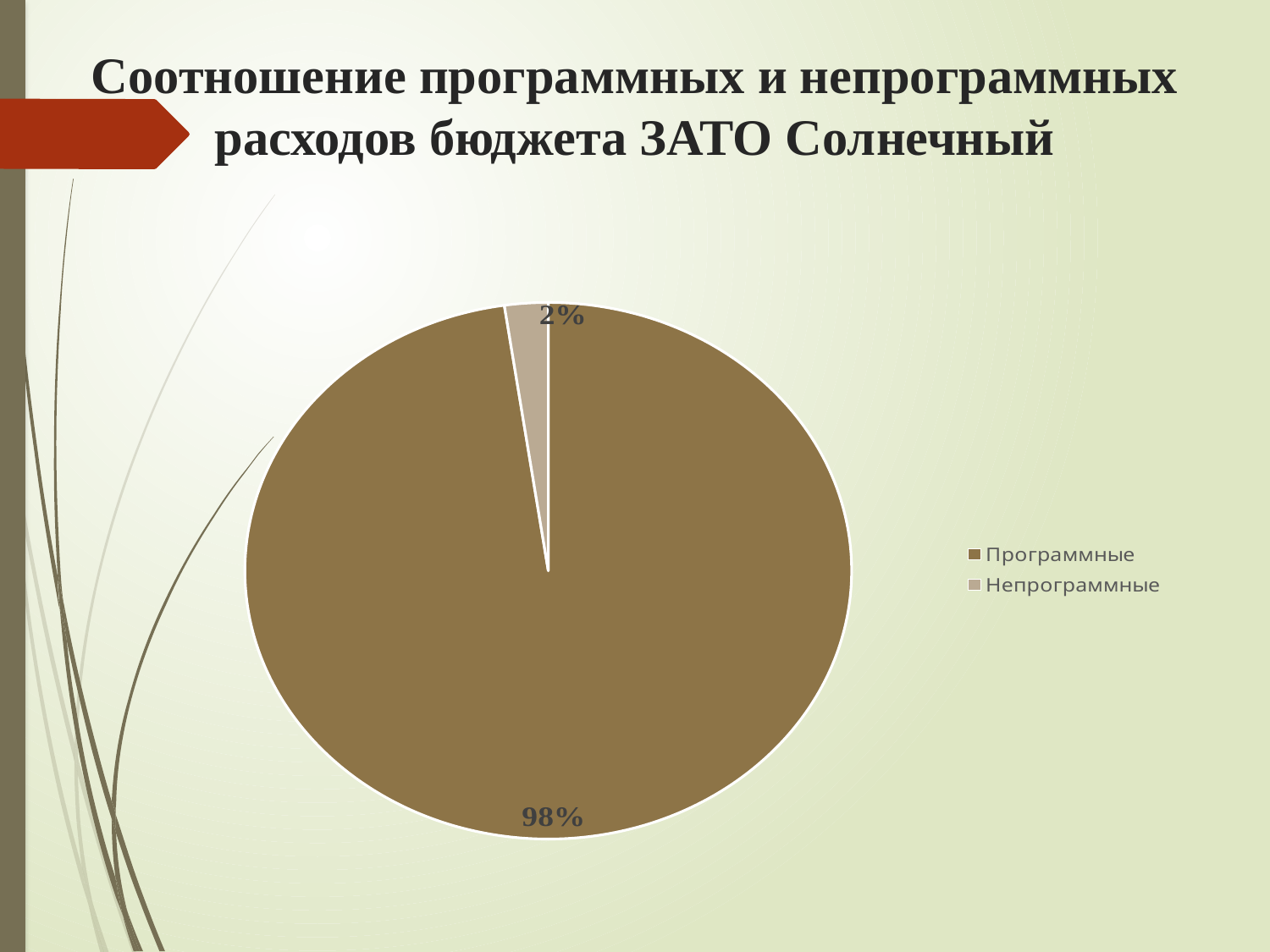
What share of the pie does Непрограммные take? 2% Which legend entry is listed first? Программные How many slices does the pie chart have? 2 What kind of chart is shown on the slide? pie chart Which category has the smallest slice of the pie? Непрограммные What is the difference in percentage points between Программные and Непрограммные? 96 What is the title of the slide containing the chart? Соотношение программных и непрограммных расходов бюджета ЗАТО Солнечный Which is larger, the share for Программные or the share for Непрограммные? Программные How many entries does the legend list? 2 What share of the pie does Программные take? 98% Which category has the largest slice of the pie? Программные